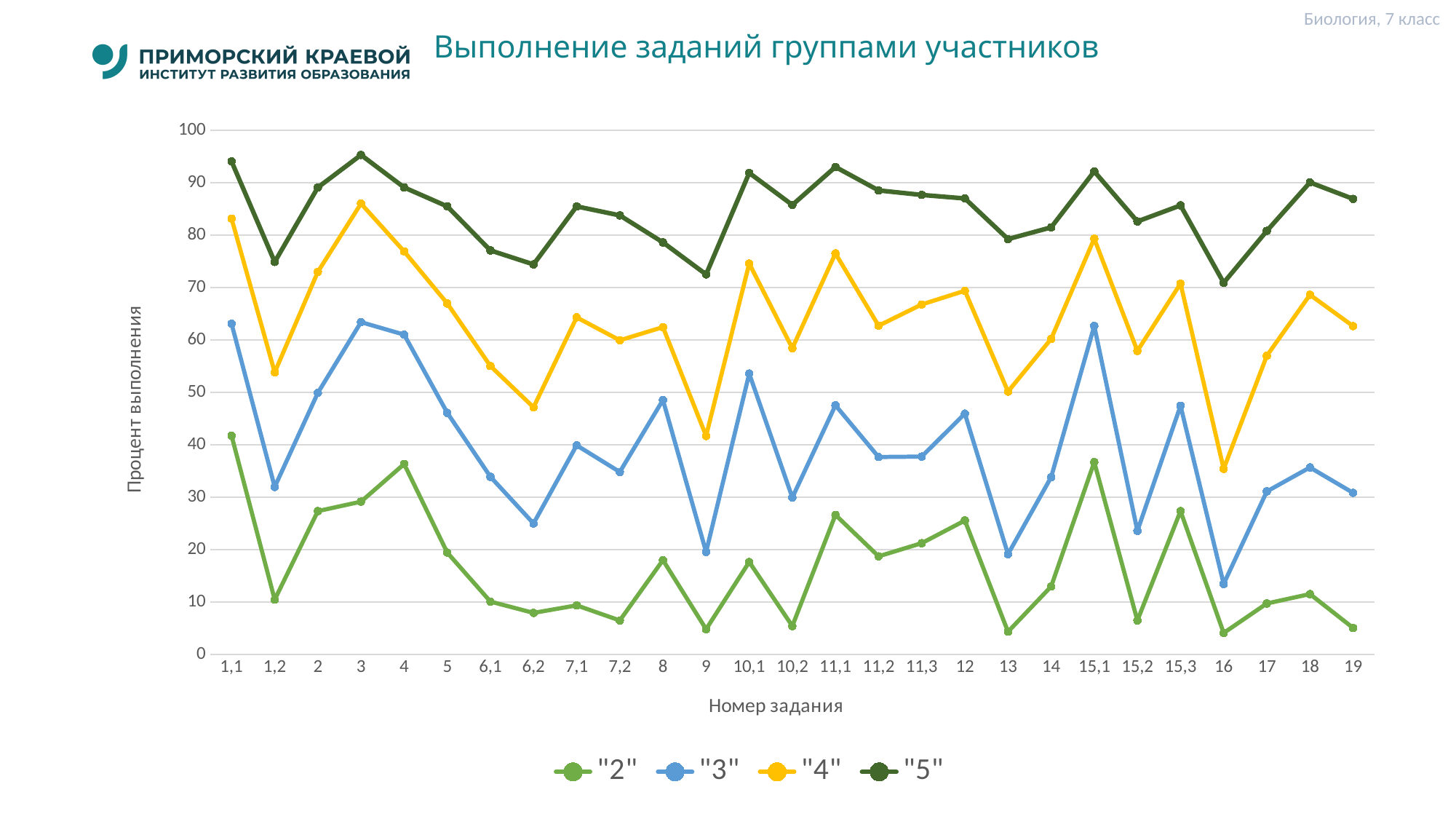
How many task numbers (categories) are shown along the x axis? 27 What is the title of the vertical axis? Процент выполнения For the "4" series, which task has the larger value: task 3 or task 5? Task 3 Is the value of the "5" series for task 1,1 greater or less than 90? greater Is the value of the "4" series for task 16 greater or less than 40? less Is the value of the "2" series for task 9 greater or less than 10? less What kind of chart is shown on the slide? Line chart For which task number does the "2" series reach its highest value? 1,1 For which task number does the "3" series reach its lowest value? 16 For which task number does the "4" series reach its lowest value? 16 Does the "3" series rise or fall from task 15,1 to task 16? Falls How many series does the legend list? 4